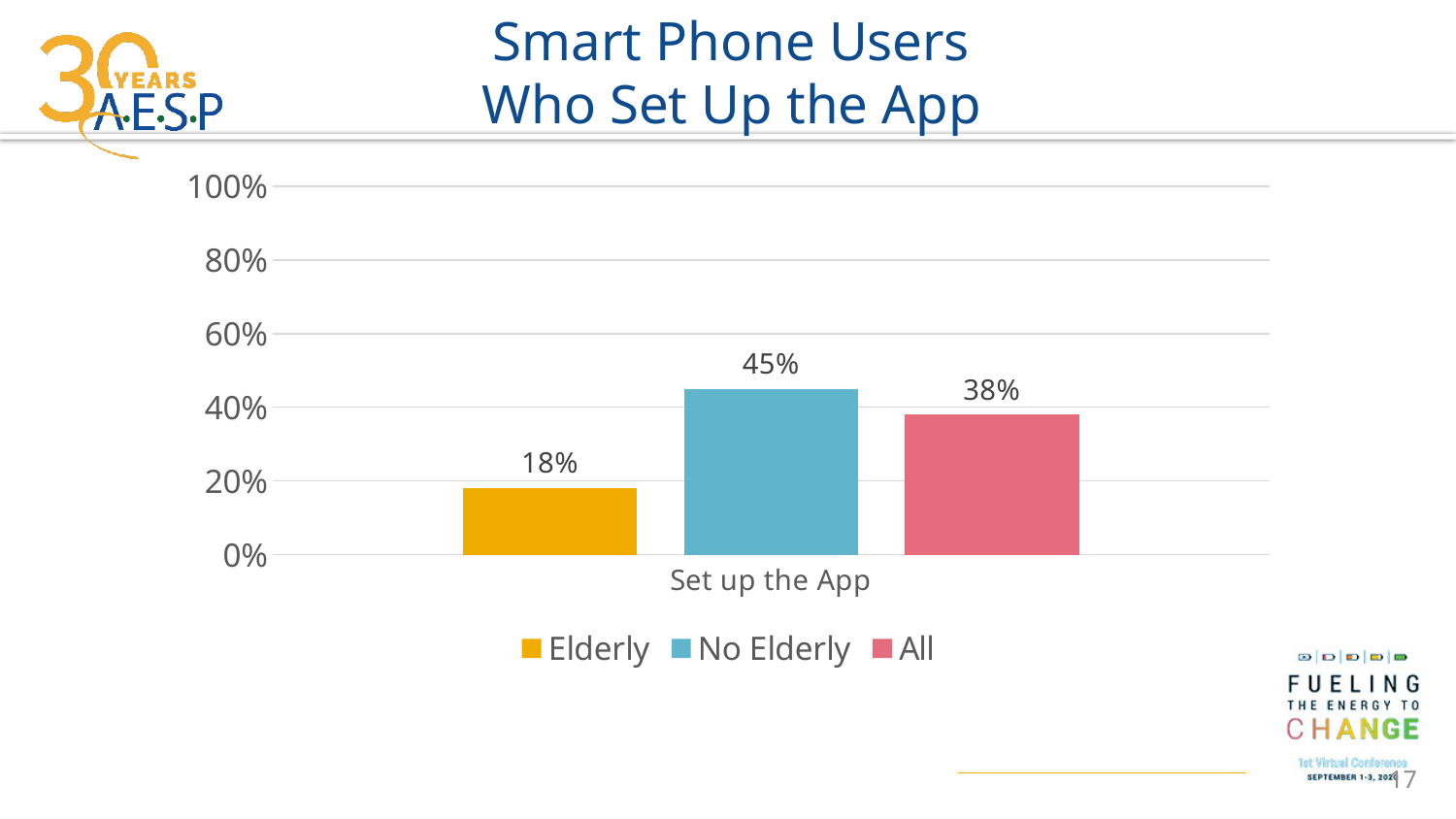
Which is larger, the value for No Elderly or the value for All? No Elderly What is the difference between the No Elderly and Elderly values? 27% What percentage of Elderly smart phone users set up the app? 18% Is the value for Elderly greater or less than 20%? less How many series does the legend list? 3 What is the title of the chart? Smart Phone Users Who Set Up the App Which series has the highest value for setting up the app? No Elderly What kind of chart is shown on the slide? Bar chart What is the value shown for the All series? 38% What is the difference between the All and Elderly values? 20% What percentage of No Elderly smart phone users set up the app? 45% Which series has the lowest value for setting up the app? Elderly